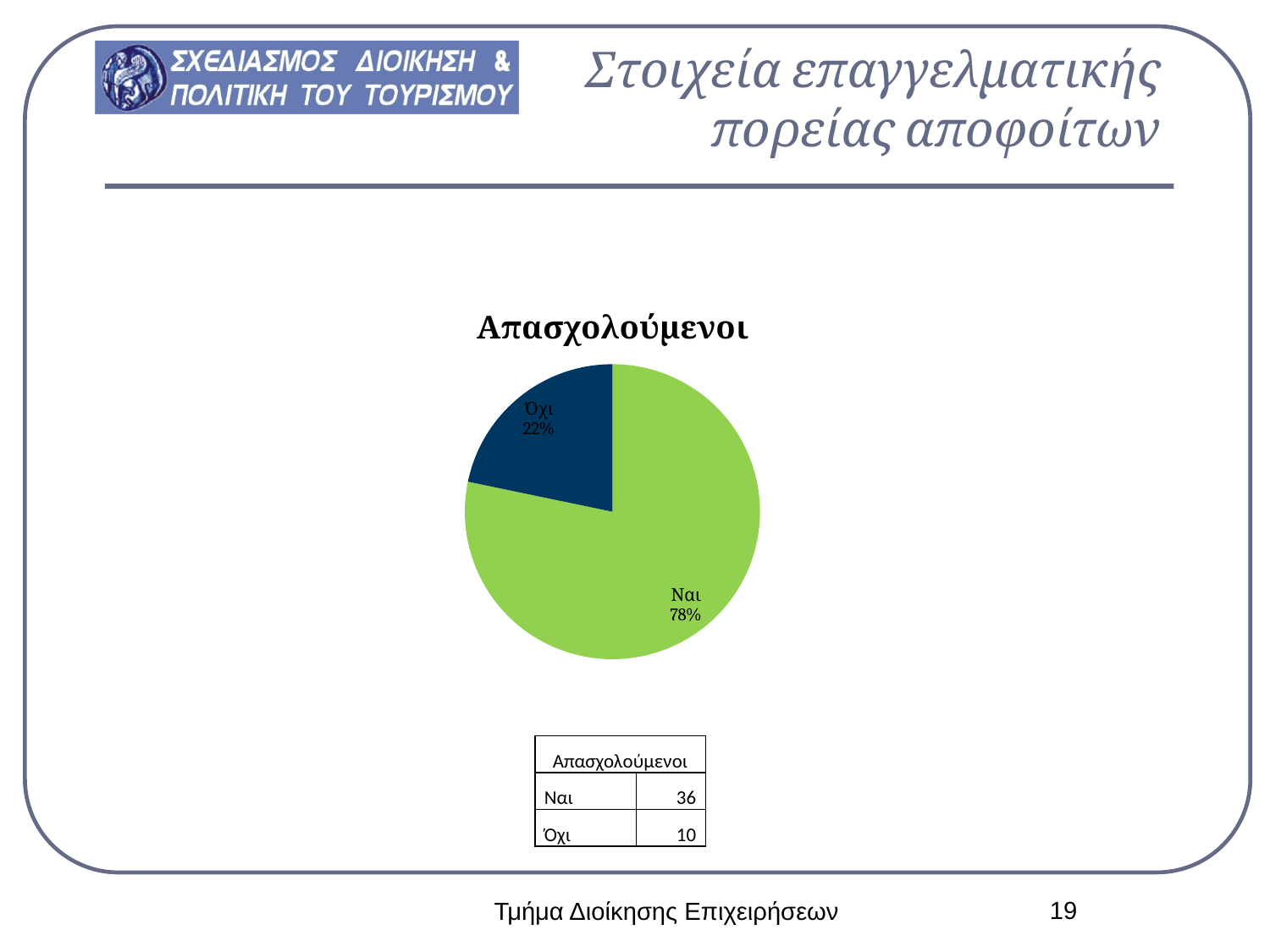
What colour is the 'Ναι' slice in the pie chart? green What is the title of the chart? Απασχολούμενοι Which slice of the pie chart is the smallest? Όχι What percentage share does the 'Όχι' slice have in the pie chart? 22% According to the table below the chart, how many respondents answered 'Ναι'? 36 What percentage share does the 'Ναι' slice have in the pie chart? 78% What type of chart is shown on the slide? pie chart According to the table below the chart, how many respondents answered 'Όχι'? 10 Which slice of the pie chart is the largest? Ναι What is the difference in percentage points between the 'Ναι' and 'Όχι' slices? 56 percentage points How many slices does the pie chart have? 2 Which is larger, the 'Ναι' slice or the 'Όχι' slice? Ναι